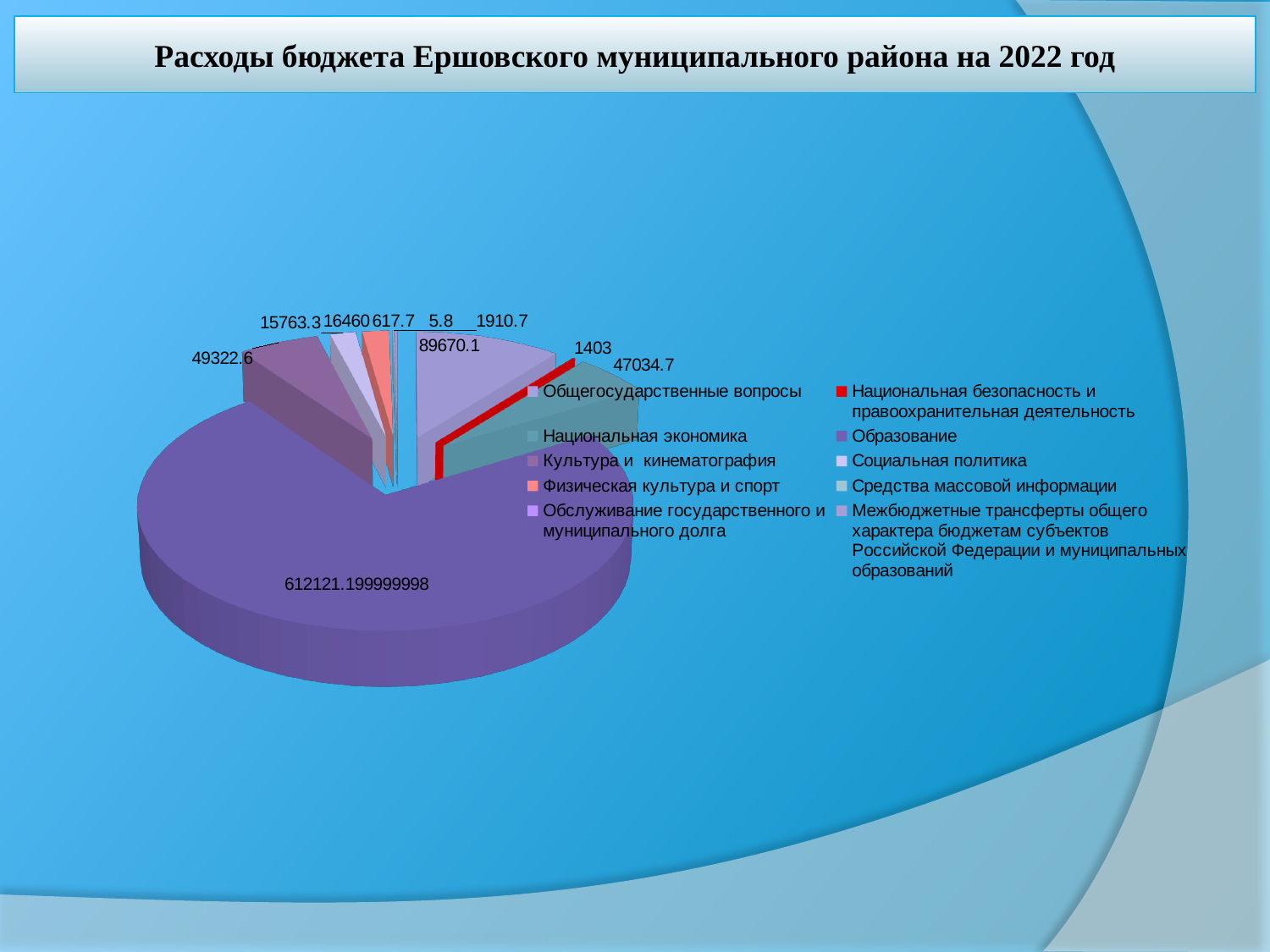
How many categories does the legend of the pie chart list? 10 Which category has the largest slice in the pie chart? Образование What kind of chart is shown on the slide? Pie chart What colour is the legend marker for Национальная безопасность и правоохранительная деятельность? Red What value is labeled on the slice for Национальная экономика? 47034.7 What is the difference between the values for Общегосударственные вопросы (89670.1) and Национальная экономика (47034.7)? 42635.4 What value is labeled on the slice for Общегосударственные вопросы? 89670.1 What is the smallest value labeled on the pie chart? 5.8 Which is larger: the value for Общегосударственные вопросы or the value for Национальная экономика? Общегосударственные вопросы What value is labeled on the largest slice (Образование)? 612121.199999998 What value is labeled on the red slice (Национальная безопасность и правоохранительная деятельность)? 1403 What is the title of the slide containing the pie chart? Расходы бюджета Ершовского муниципального района на 2022 год